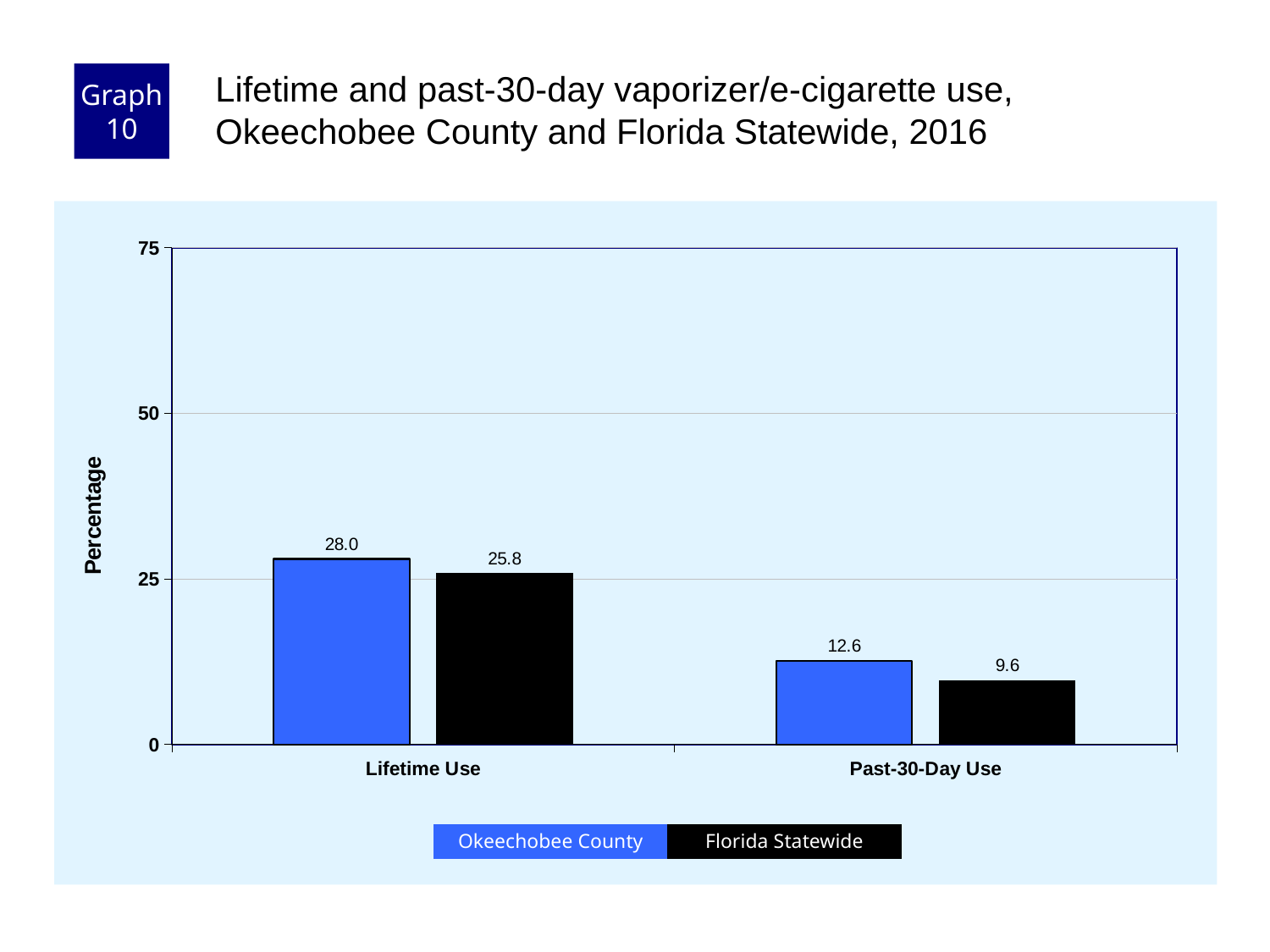
How many categories are shown on the x axis? 2 Which category has the highest Okeechobee County value? Lifetime Use Which category has the lowest Florida Statewide value? Past-30-Day Use What is the difference between the Okeechobee County and Florida Statewide values for Lifetime Use? 2.2 What is the Okeechobee County value for Lifetime Use? 28.0 What kind of chart is shown on the slide? bar chart What is the difference between the Okeechobee County and Florida Statewide values for Past-30-Day Use? 3.0 Is the Okeechobee County value for Lifetime Use greater or less than 25? greater What is the Florida Statewide value for Lifetime Use? 25.8 What is the Florida Statewide value for Past-30-Day Use? 9.6 For Past-30-Day Use, which is larger: Okeechobee County or Florida Statewide? Okeechobee County How many series does the legend list? 2